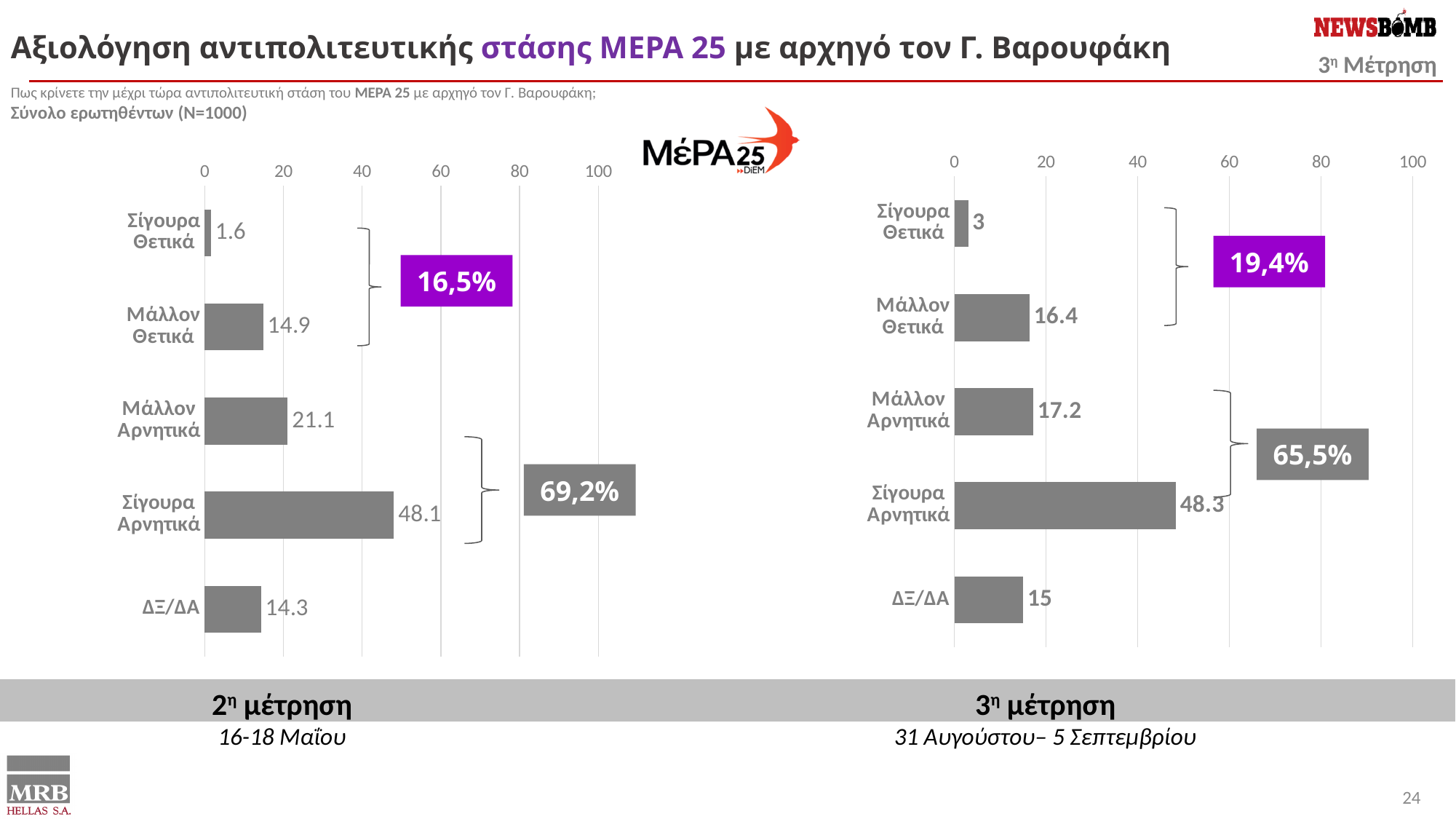
In the right chart (3η μέτρηση), what is the value for Μάλλον Θετικά? 16.4 In the right chart (3η μέτρηση), which category has the highest value? Σίγουρα Αρνητικά In the left chart (2η μέτρηση), which category has the lowest value? Σίγουρα Θετικά In the left chart (2η μέτρηση), what is the difference between Μάλλον Αρνητικά and Μάλλον Θετικά? 6.2 In the right chart (3η μέτρηση), what combined percentage is shown in the purple box for the negative responses? 65,5% In the left chart (2η μέτρηση), is the value for Σίγουρα Αρνητικά greater or less than 40? greater In the right chart (3η μέτρηση), what is the value for Σίγουρα Θετικά? 3 In the right chart (3η μέτρηση), what is the difference between Σίγουρα Αρνητικά and ΔΞ/ΔΑ? 33.3 In the left chart (2η μέτρηση), what is the value for Σίγουρα Αρνητικά? 48.1 Is the value for Μάλλον Αρνητικά larger in the left chart (2η μέτρηση) or in the right chart (3η μέτρηση)? Left chart (2η μέτρηση) How many categories are shown in the right chart (3η μέτρηση)? 5 What type of chart is the left chart (2η μέτρηση)? Bar chart